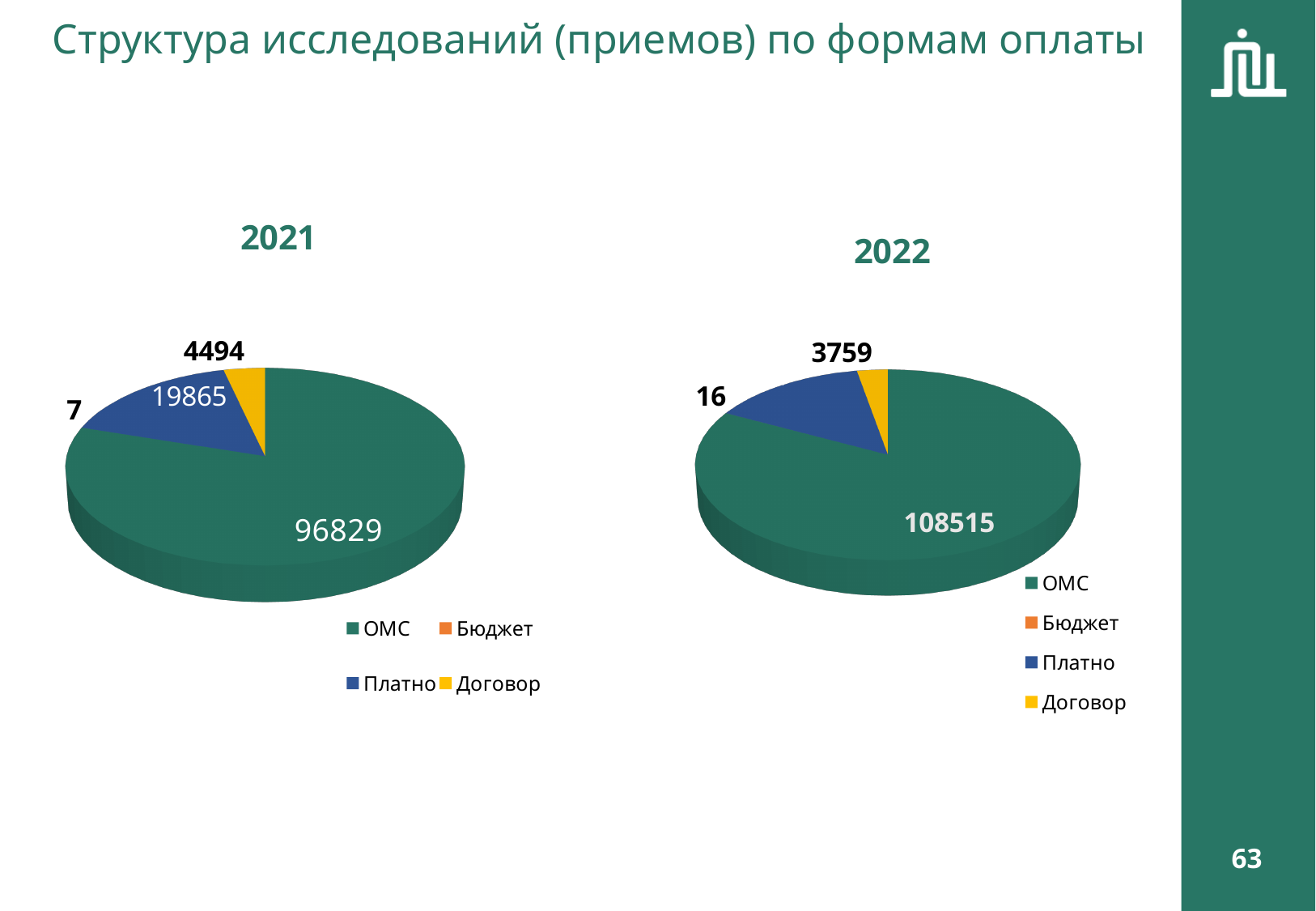
In the 2021 chart, which category has the largest slice? ОМС In the 2021 chart, what is the value for Платно? 19865 In the 2022 chart, what is the value for Бюджет? 16 How many categories does the legend of the 2022 chart list? 4 Which year has the larger value for ОМС, 2021 or 2022? 2022 In the 2021 chart, what is the value for Договор? 4494 In the 2021 chart, which category has the smallest value? Бюджет In the 2021 chart, what is the value for ОМС? 96829 What type of charts are shown on the slide? Pie charts In the 2021 chart, what is the value for Бюджет? 7 What is the difference between the ОМС value in the 2022 chart and the ОМС value in the 2021 chart? 11686 In the 2022 chart, what is the value for ОМС? 108515